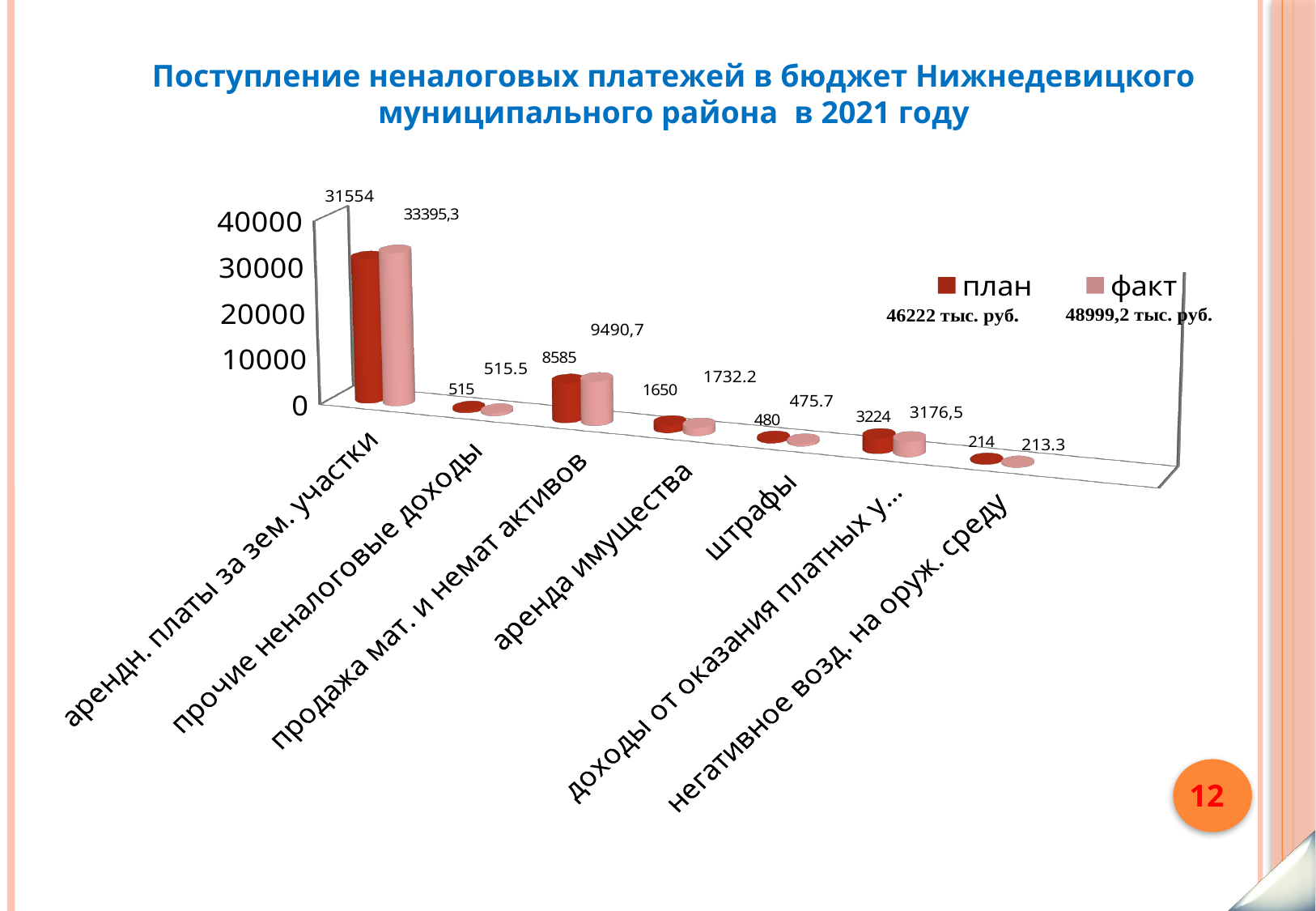
What is the план value for негативное возд. на оруж. среду? 214 How many series does the legend list? 2 Which category has the lowest план value? негативное возд. на оруж. среду What is the план value for арендн. платы за зем. участки? 31554 Which category has the highest факт value? арендн. платы за зем. участки What kind of chart is shown on the slide? bar chart What is the difference between the факт and план values for арендн. платы за зем. участки? 1841,3 What is the факт value for продажа мат. и немат активов? 9490,7 How many categories are shown on the x axis? 7 What is the факт value for штрафы? 475.7 What is the difference between the факт and план values for аренда имущества? 82.2 Which is larger for продажа мат. и немат активов, план or факт? факт